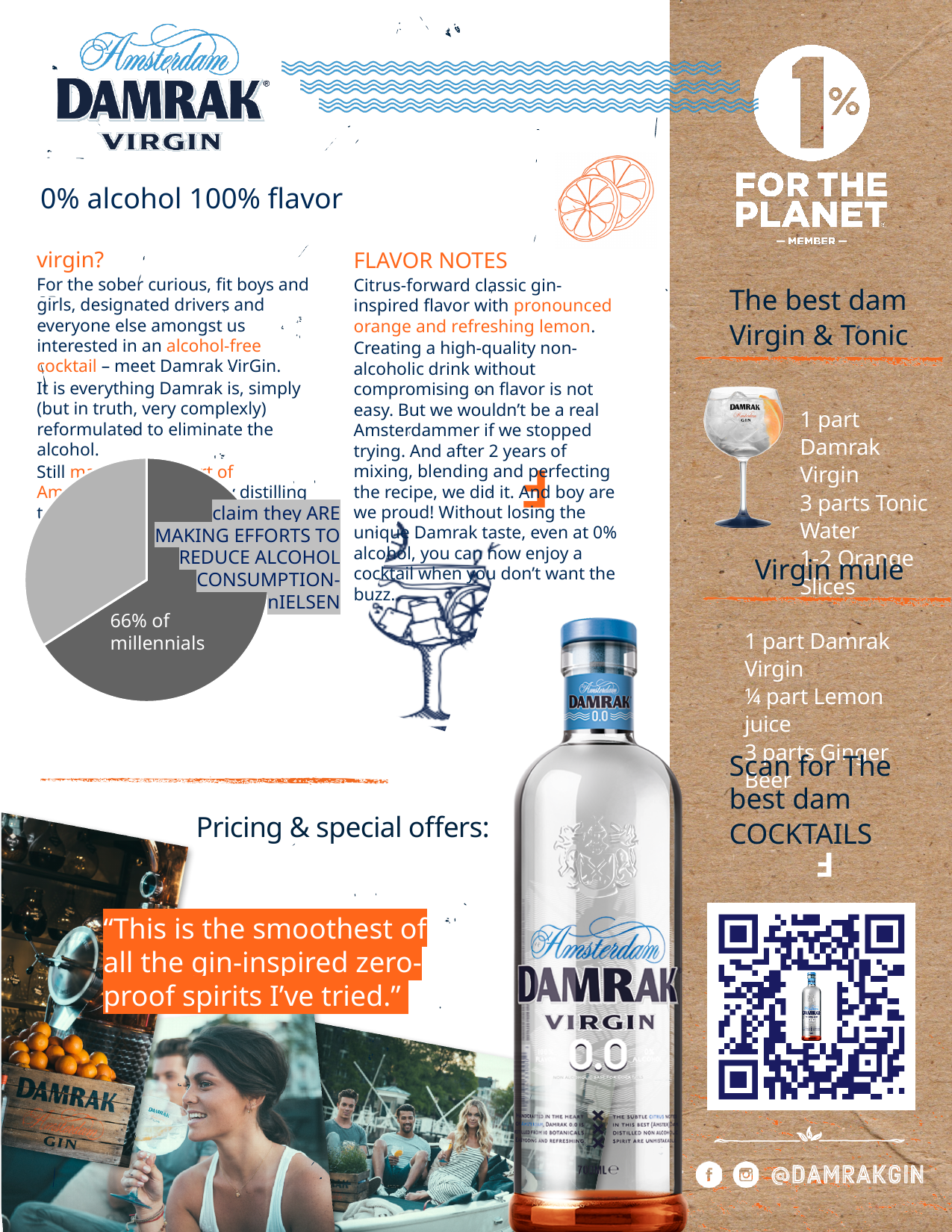
Is the slice labelled 66% of millennials greater or less than half of the pie? greater Which slice of the pie chart is the largest? 66% of millennials Is the unlabelled lighter slice of the pie chart greater or less than half of the pie? less According to the text next to the pie chart, what do 66% of millennials claim they are making efforts to reduce? alcohol consumption What colour is the slice labelled 66% of millennials in the pie chart? dark grey How many slices does the pie chart have? 2 What kind of chart is shown on the slide? pie chart Which slice is larger in the pie chart, the dark grey slice or the light grey slice? the dark grey slice What percentage is printed on the pie chart's labelled slice? 66% Which group does the 66% slice of the pie chart refer to? millennials